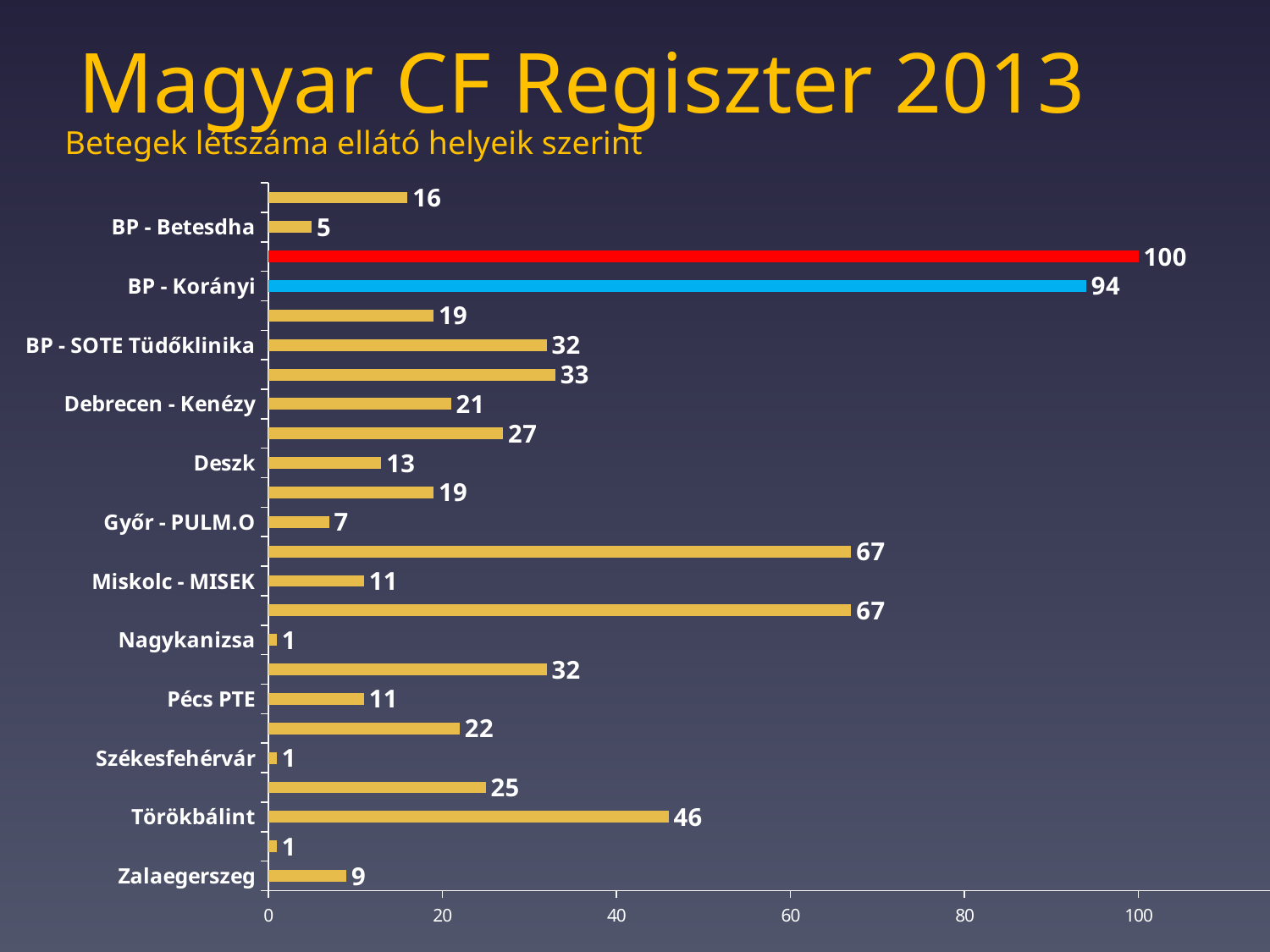
What kind of chart is shown on the slide? bar chart What is the value of the bar labelled BP - Korányi? 94 How many category labels are shown on the vertical axis? 12 What is the value of the bar labelled Törökbálint? 46 What is the value of the bar labelled Deszk? 13 What is the highest value shown on the chart? 100 What is the value of the bar labelled Zalaegerszeg? 9 What is the subtitle shown above the chart? Betegek létszáma ellátó helyeik szerint What is the value of the bar labelled Győr - PULM.O? 7 What colour is the longest bar on the chart? red Which has a larger value, Törökbálint or Zalaegerszeg? Törökbálint What is the difference between the longest bar (100) and the bar labelled BP - Korányi (94)? 6